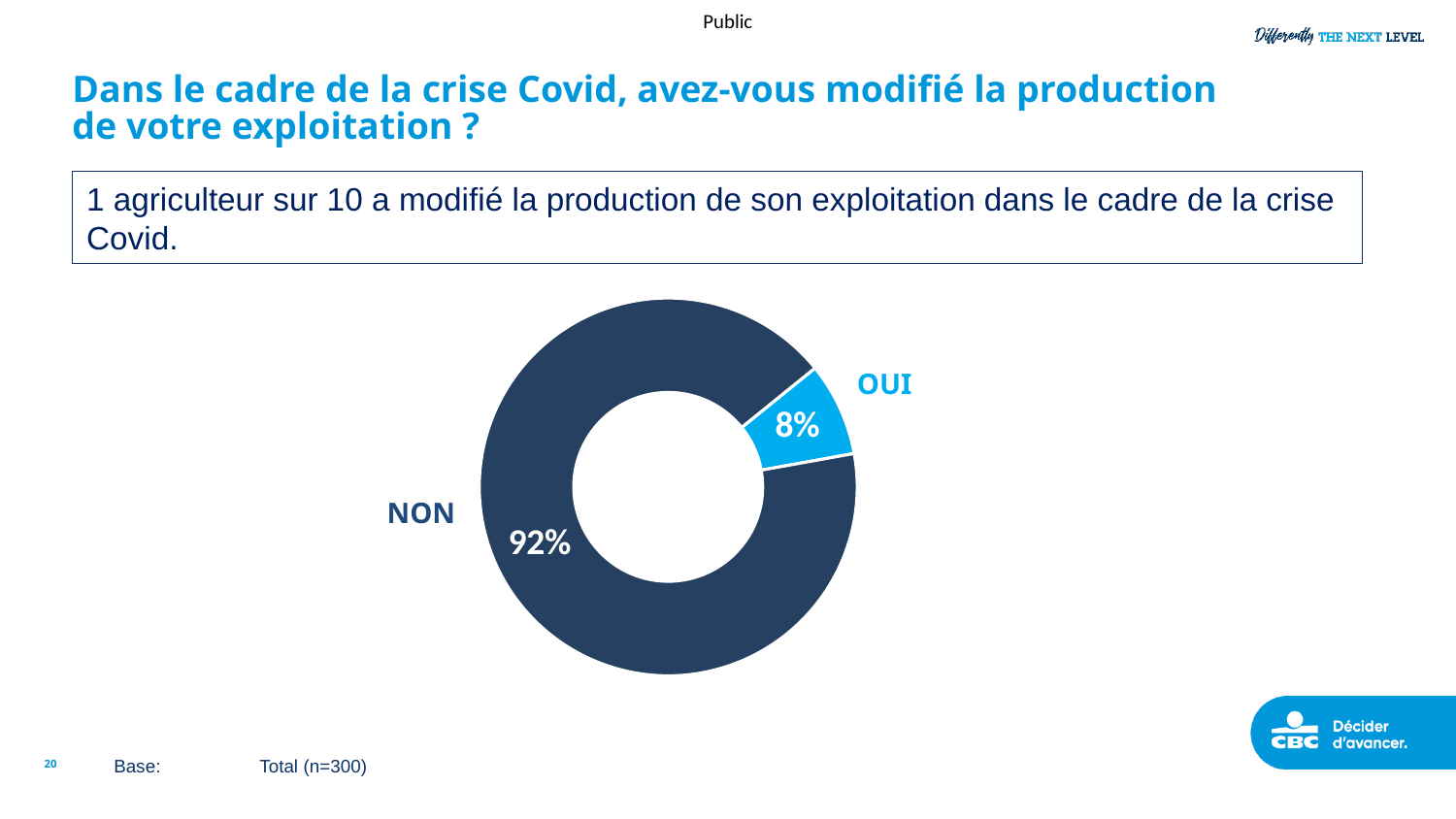
What kind of chart is shown on the slide? Pie chart (donut) What is the base (sample size) stated for the chart? Total (n=300) Which is larger, the share for OUI or the share for NON? NON Which category has the largest share of the chart? NON What share of the pie does the OUI slice represent? 8% What is the total of the two slices shown in the chart? 100% How many categories are shown in the chart? 2 What percentage of respondents answered NON? 92% What colour is the OUI slice of the chart? Light blue What percentage of respondents answered OUI? 8% Which category has the smallest share of the chart? OUI What is the difference in percentage points between NON and OUI? 84